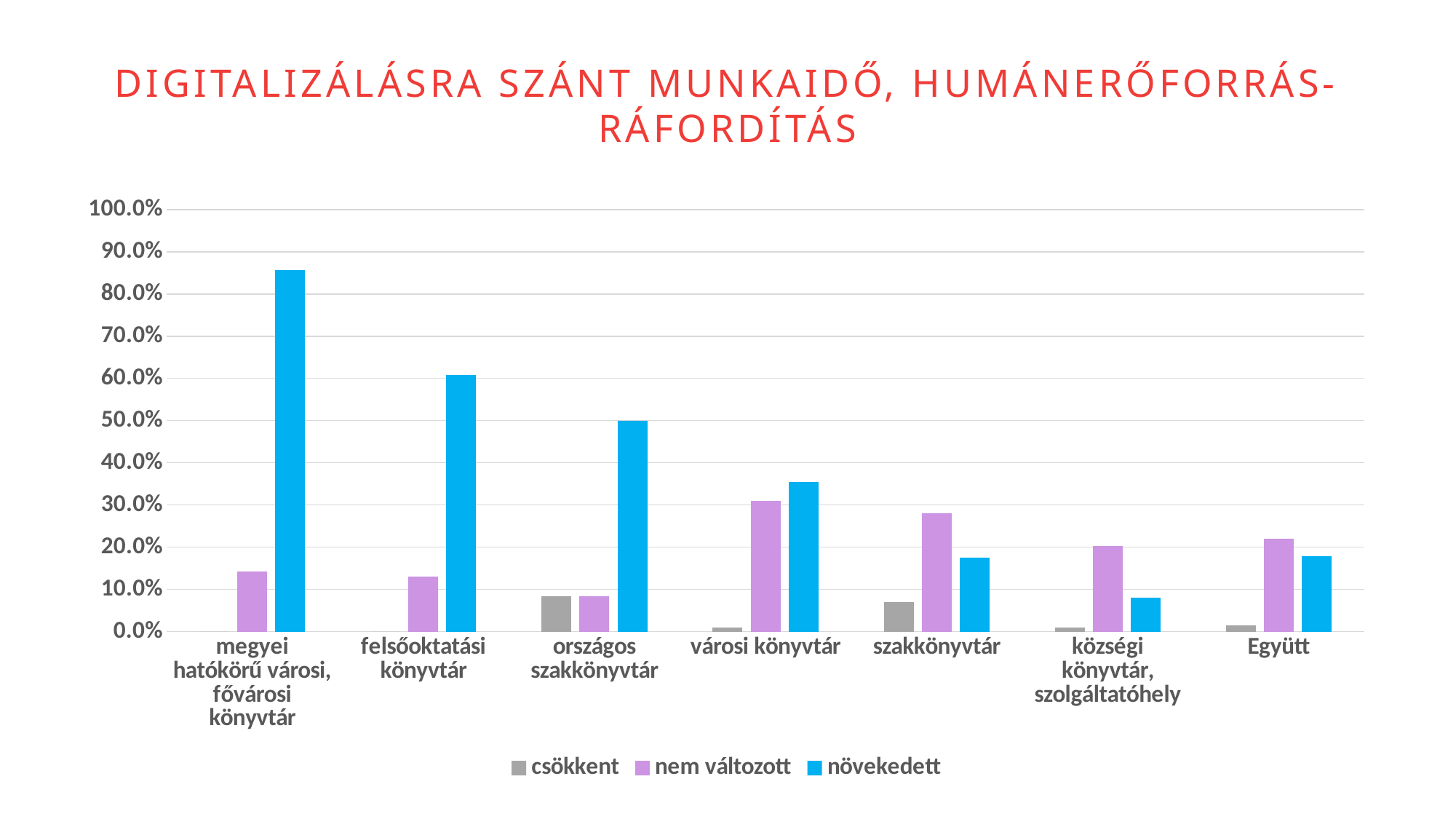
Is the 'növekedett' value for 'felsőoktatási könyvtár' greater or less than 50.0%? greater How many series does the legend list? 3 Is the 'nem változott' value for 'községi könyvtár, szolgáltatóhely' greater or less than 10.0%? greater What kind of chart is shown on the slide? bar chart Which legend entry is shown in blue? növekedett Which category has the highest value for the 'növekedett' series? megyei hatókörű városi, fővárosi könyvtár For 'városi könyvtár', which is larger: 'nem változott' or 'növekedett'? növekedett Is the 'növekedett' value for 'Együtt' greater or less than 20.0%? less For 'szakkönyvtár', which is larger: 'nem változott' or 'növekedett'? nem változott How many categories are shown on the x axis? 7 Which category has the lowest value for the 'növekedett' series? községi könyvtár, szolgáltatóhely